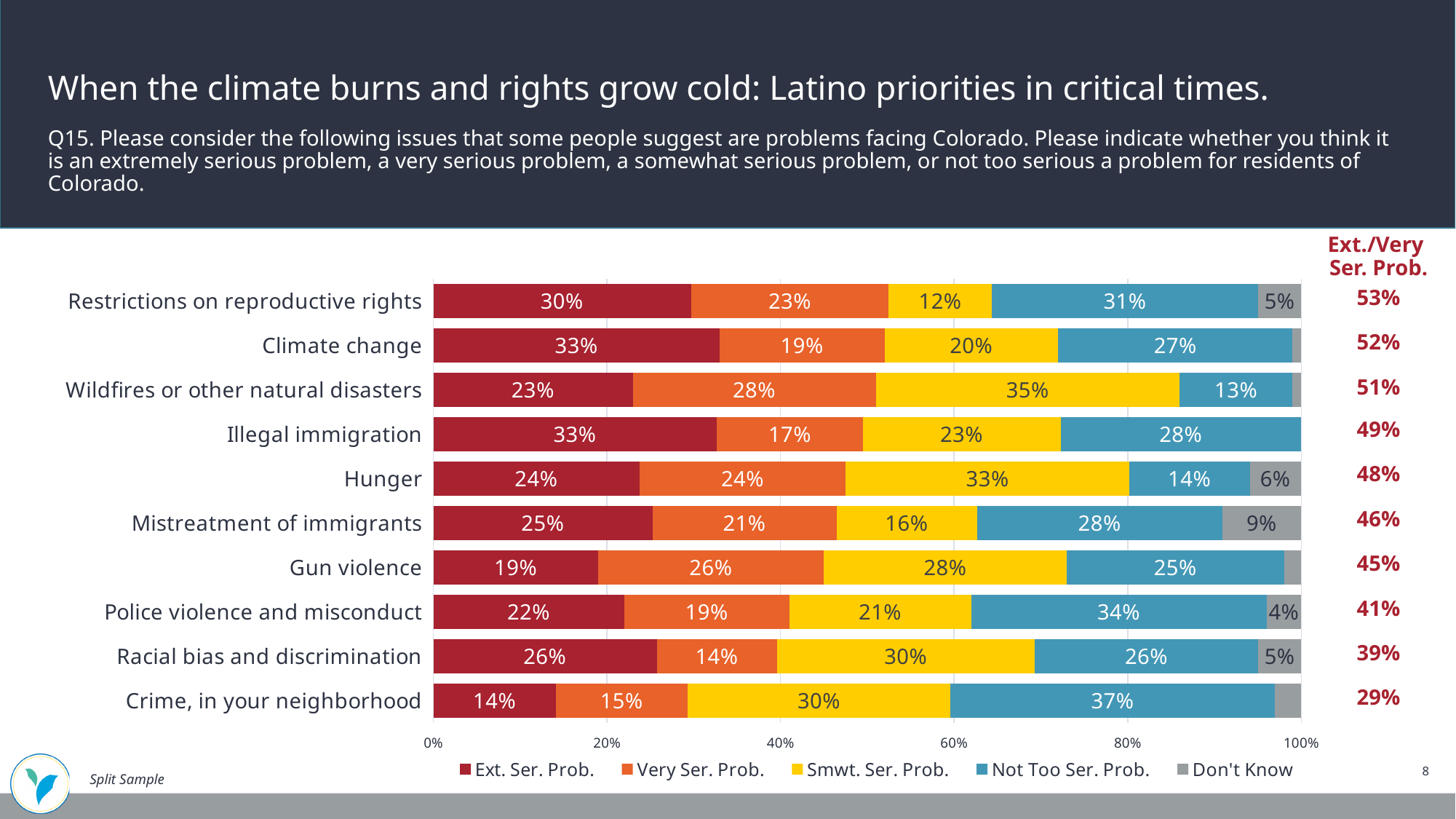
What is the Don't Know share for Mistreatment of immigrants? 9% Which has a larger Not Too Ser. Prob. value: Police violence and misconduct or Racial bias and discrimination? Police violence and misconduct What percentage of respondents rated Climate change as an extremely serious problem (Ext. Ser. Prob.)? 33% How many issues are listed in the chart? 10 What is the Not Too Ser. Prob. value for Crime, in your neighborhood? 37% What kind of chart is shown on the slide? Stacked bar chart What is the combined Ext./Very Ser. Prob. figure shown for Hunger? 48% Which issue has the highest Smwt. Ser. Prob. value? Wildfires or other natural disasters Which issue has the highest combined Ext./Very Ser. Prob. figure? Restrictions on reproductive rights What is the difference in Ext. Ser. Prob. between Illegal immigration and Crime, in your neighborhood? 19 percentage points How many series does the legend list? 5 Which issue has the lowest Ext. Ser. Prob. value? Crime, in your neighborhood